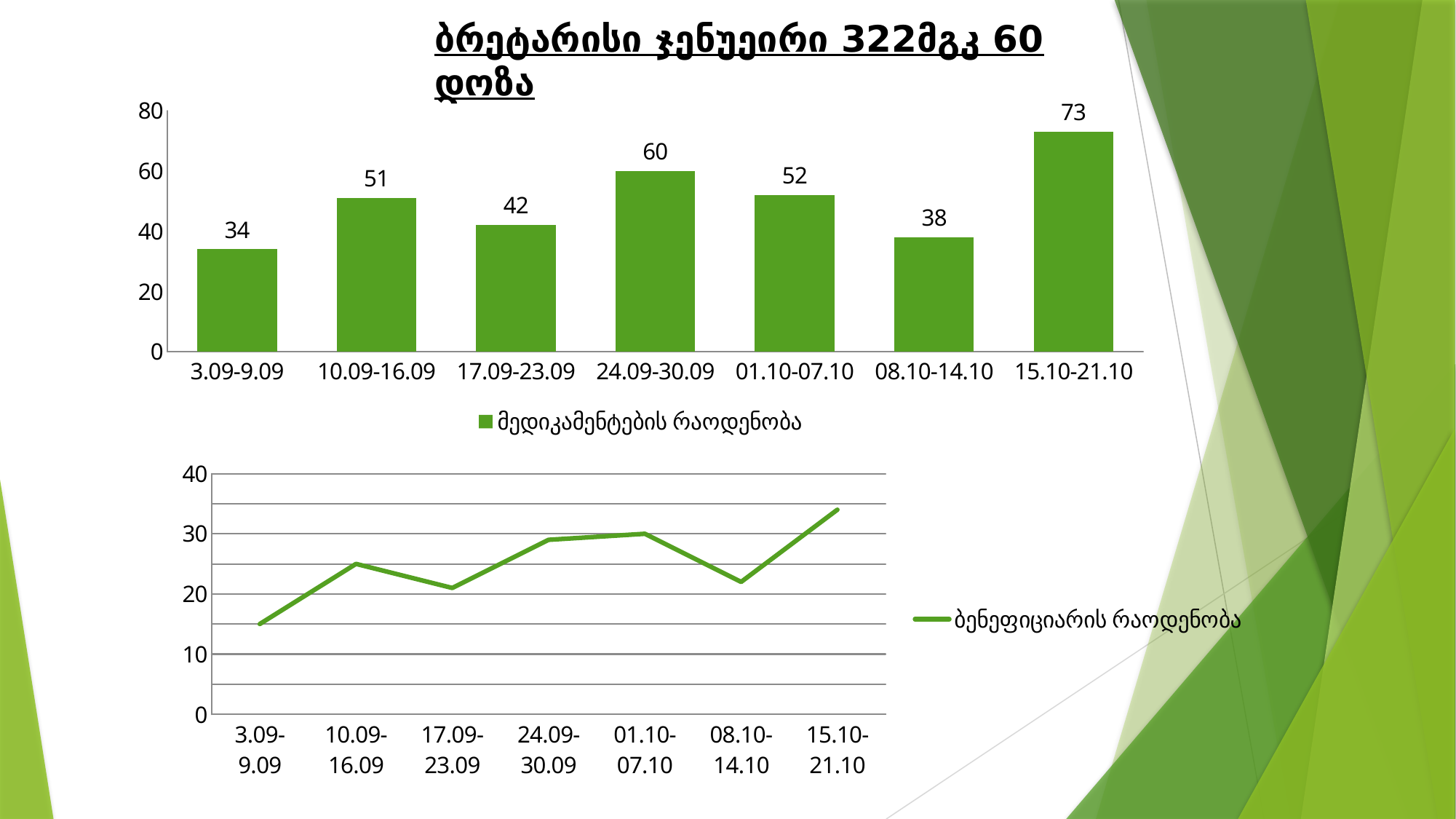
What kind of chart is the top chart on the slide? bar chart In the top bar chart, what is the difference between the values for 24.09-30.09 and 08.10-14.10? 22 In the bottom line chart, is the value for 15.10-21.10 greater or less than 30? greater What kind of chart is the bottom chart on the slide? line chart How many series does the legend of the bottom line chart list? 1 In the top bar chart, which period has the highest value? 15.10-21.10 In the top bar chart, what is the value for 15.10-21.10? 73 In the top bar chart, which is larger: the value for 10.09-16.09 or the value for 01.10-07.10? 01.10-07.10 In the bottom line chart, is the value for 3.09-9.09 greater or less than 20? less In the top bar chart, what is the value for 17.09-23.09? 42 In the top bar chart, which period has the lowest value? 3.09-9.09 How many periods are shown on the x axis of the top bar chart? 7